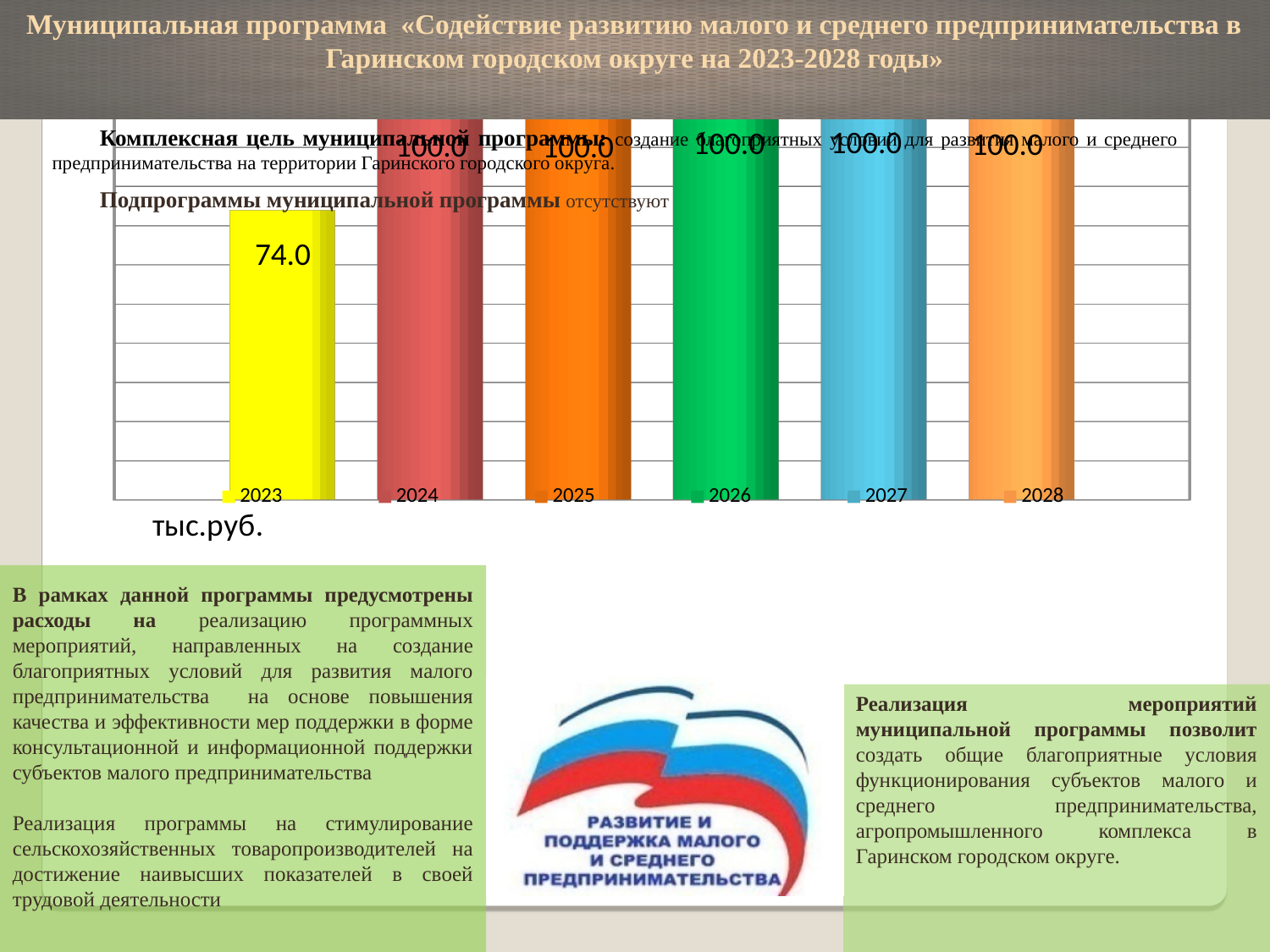
What kind of chart is shown on the slide? bar chart What is the value for 2028 in the chart? 100.0 What is the value for 2023 in the chart? 74.0 How many years are shown in the chart? 6 What is the value for 2024 in the chart? 100.0 Do the values rise or fall from 2023 to 2024? rise How many years have a value of 100.0? 5 What colour is the bar for 2023? yellow Which year has the lowest value in the chart? 2023 What is the difference between the values for 2024 and 2023? 26.0 Which is larger, the value for 2023 or the value for 2025? 2025 What unit is indicated below the chart? тыс.руб.